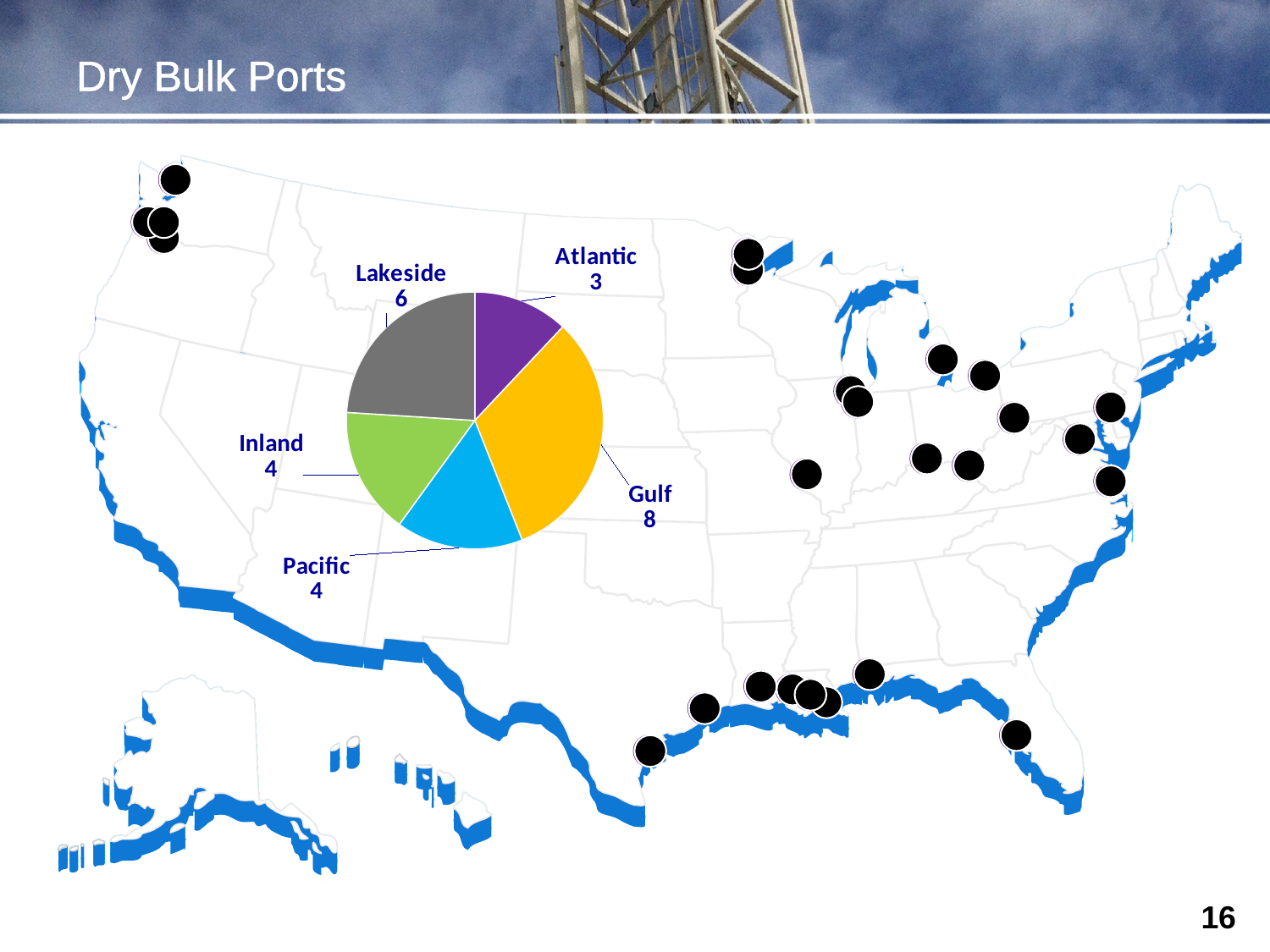
Which category has the largest slice in the pie chart? Gulf Which category has the smallest slice in the pie chart? Atlantic How many categories does the pie chart have? 5 What kind of chart is shown on the slide? pie chart What colour is the Gulf slice in the pie chart? yellow What is the value for Atlantic in the pie chart? 3 What is the difference between the Gulf and Atlantic values in the pie chart? 5 Which is larger in the pie chart, Lakeside or Pacific? Lakeside What is the total of all the values shown in the pie chart? 25 What share of the pie chart does the Gulf slice represent? 32% What is the value for Lakeside in the pie chart? 6 What is the value for Gulf in the pie chart? 8